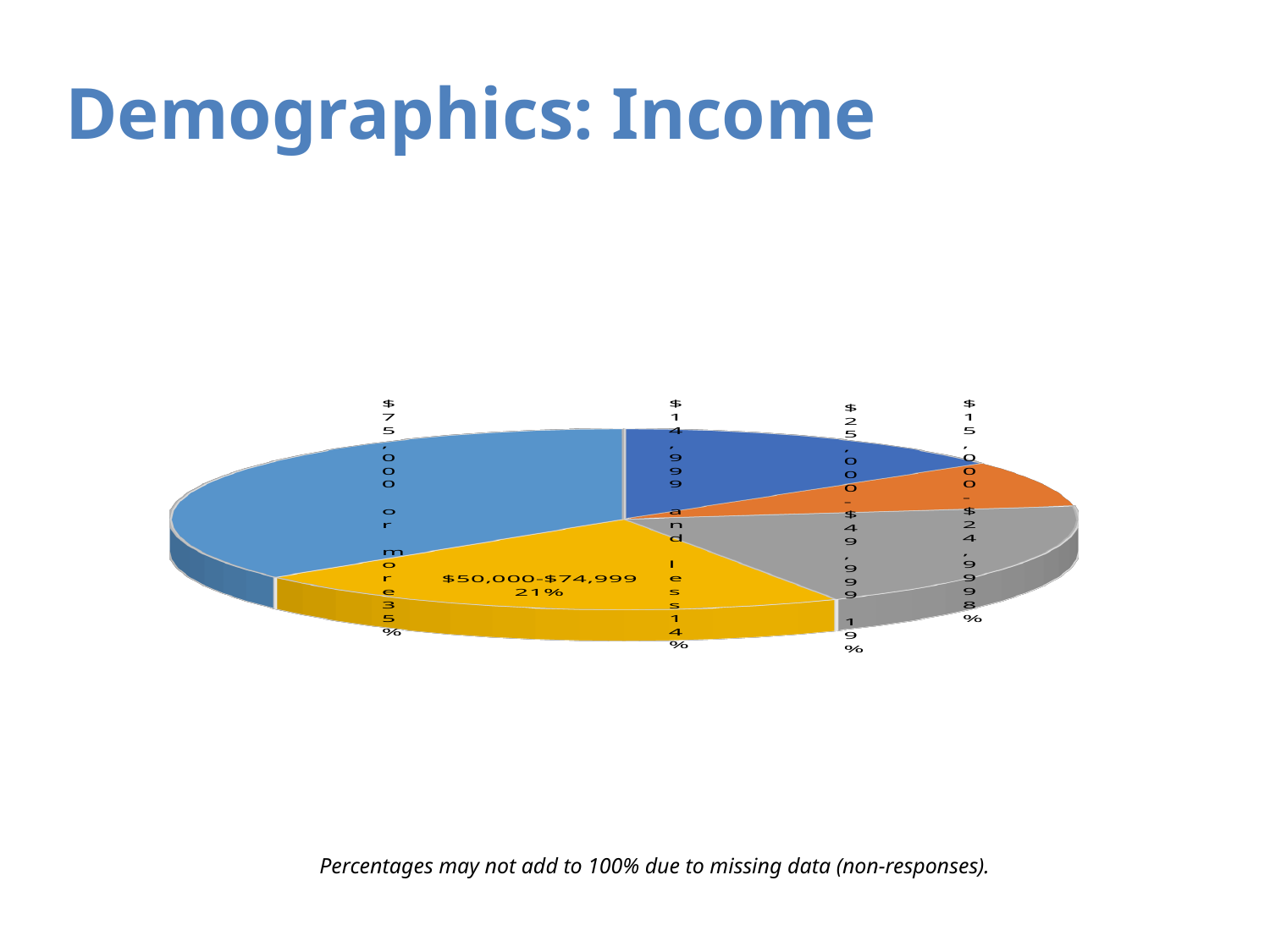
What is the title of the slide containing the chart? Demographics: Income What is the difference in percentage points between the $75,000 or more slice and the $50,000-$74,999 slice? 14 Which is larger: the share for $25,000-$49,999 or the share for $14,999 and less? $25,000-$49,999 What percentage of respondents fall in the $50,000-$74,999 income category? 21% How many income categories (slices) does the pie chart show? 5 Which income category has the smallest share of the pie? $15,000-$24,999 Which income category has the largest share of the pie? $75,000 or more What kind of chart is shown on the slide? Pie chart What percentage of respondents fall in the $25,000-$49,999 income category? 19% What percentage of respondents have an income of $14,999 and less? 14% What percentage of respondents fall in the $15,000-$24,999 income category? 8% What percentage of respondents have an income of $75,000 or more? 35%